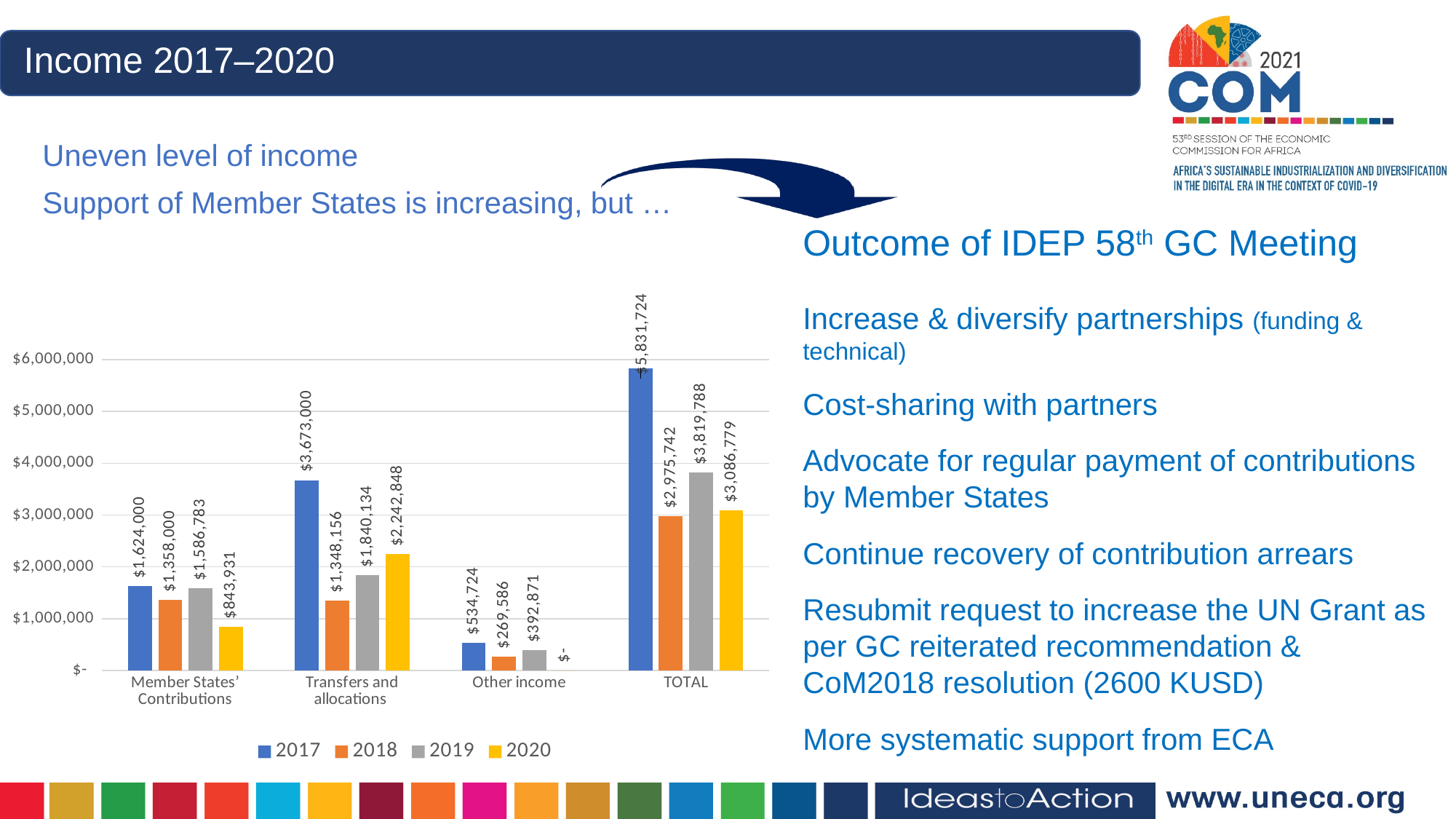
What is the value for Transfers and allocations in 2020? $2,242,848 What is the value for Member States' Contributions in 2017? $1,624,000 Which is larger for Transfers and allocations: the 2018 value or the 2019 value? 2019 Which year has the highest TOTAL? 2017 Is the TOTAL value for 2018 greater or less than $3,000,000? less What is the value for Other income in 2018? $269,586 What is the difference between the 2020 and 2019 values for Transfers and allocations? $402,714 What kind of chart is shown on the slide? Bar chart How many categories are shown on the x axis? 4 Which year has the lowest value for Member States' Contributions? 2020 What is the TOTAL value for 2019? $3,819,788 How many series does the legend list? 4